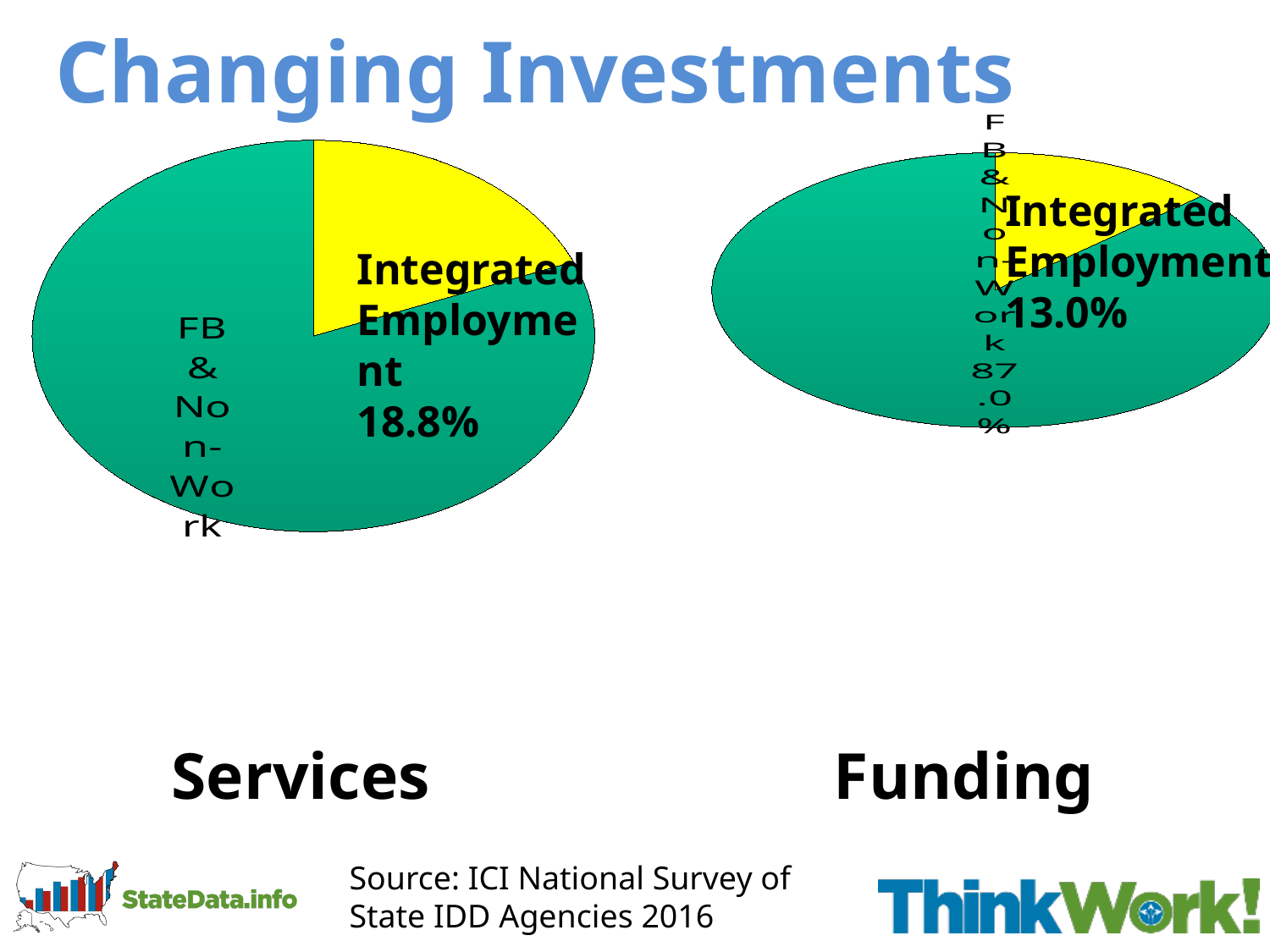
What kind of chart is the Funding chart? Pie chart In the Funding pie chart, what share is labelled for Integrated Employment? 13.0% In the Services pie chart, what share is labelled for Integrated Employment? 18.8% What kind of chart is the Services chart? Pie chart In the Funding pie chart, what is the difference between the FB & Non-Work share and the Integrated Employment share? 74.0% How many slices does the Funding pie chart have? 2 In the Funding pie chart, which slice is the largest? FB & Non-Work Is the Integrated Employment share larger in the Services pie chart or the Funding pie chart? Services In the Services pie chart, what colour is the Integrated Employment slice? Yellow In the Services pie chart, which slice is the smallest? Integrated Employment In the Funding pie chart, what share is labelled for FB & Non-Work? 87.0% How many slices does the Services pie chart have? 2